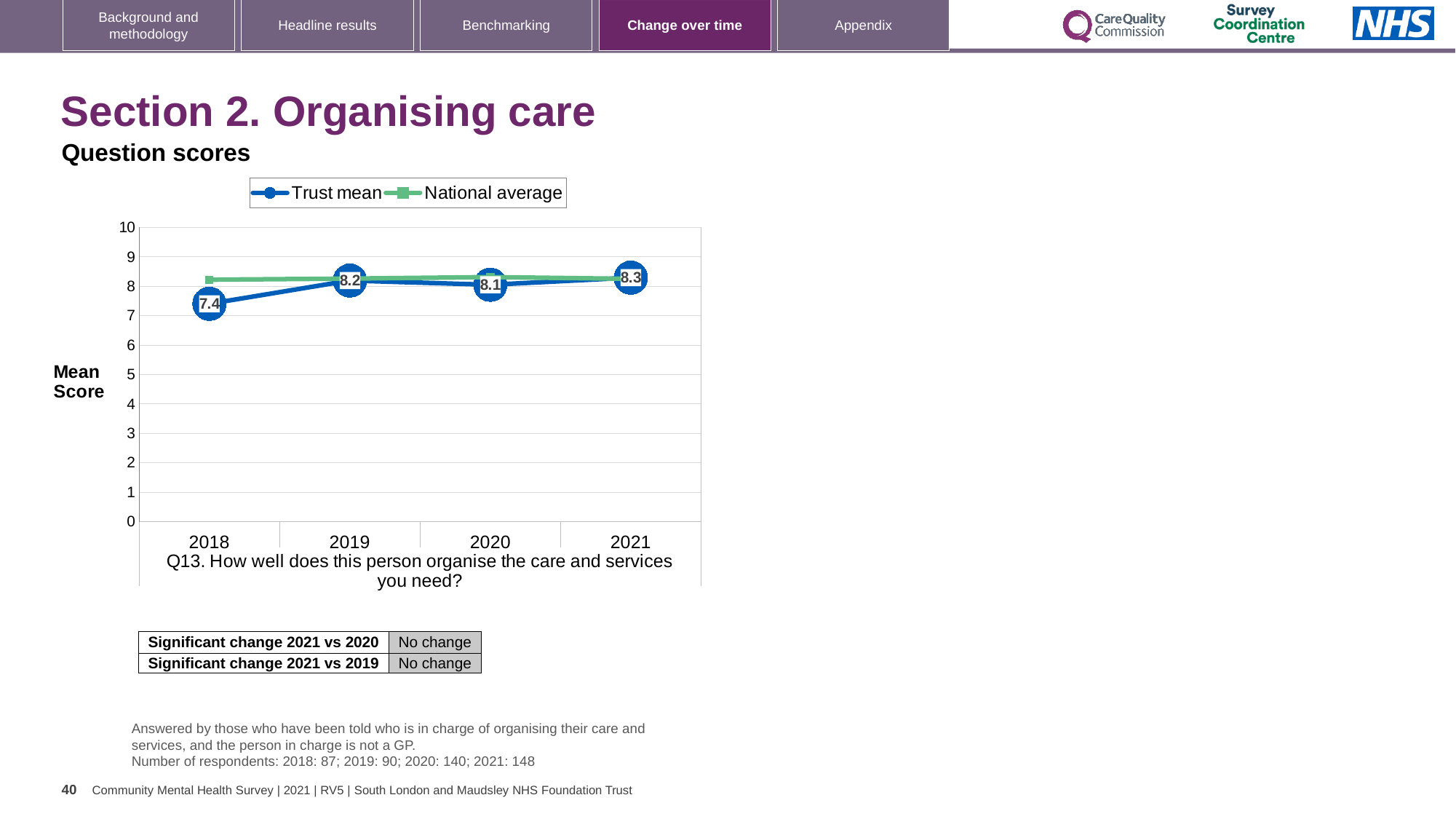
What is the difference between the Trust mean scores for 2019 and 2018? 0.8 How many years are plotted on the x axis? 4 Is the National average for 2020 greater or less than 7? greater What is the Trust mean score for 2018? 7.4 What kind of chart is shown? Line chart In which year is the Trust mean score lowest? 2018 How many series does the legend list? 2 What is the Trust mean score for 2020? 8.1 In which year is the Trust mean score highest? 2021 Does the Trust mean rise or fall from 2018 to 2019? Rise In 2018, which is higher: the Trust mean or the National average? National average What is the Trust mean score for 2021? 8.3